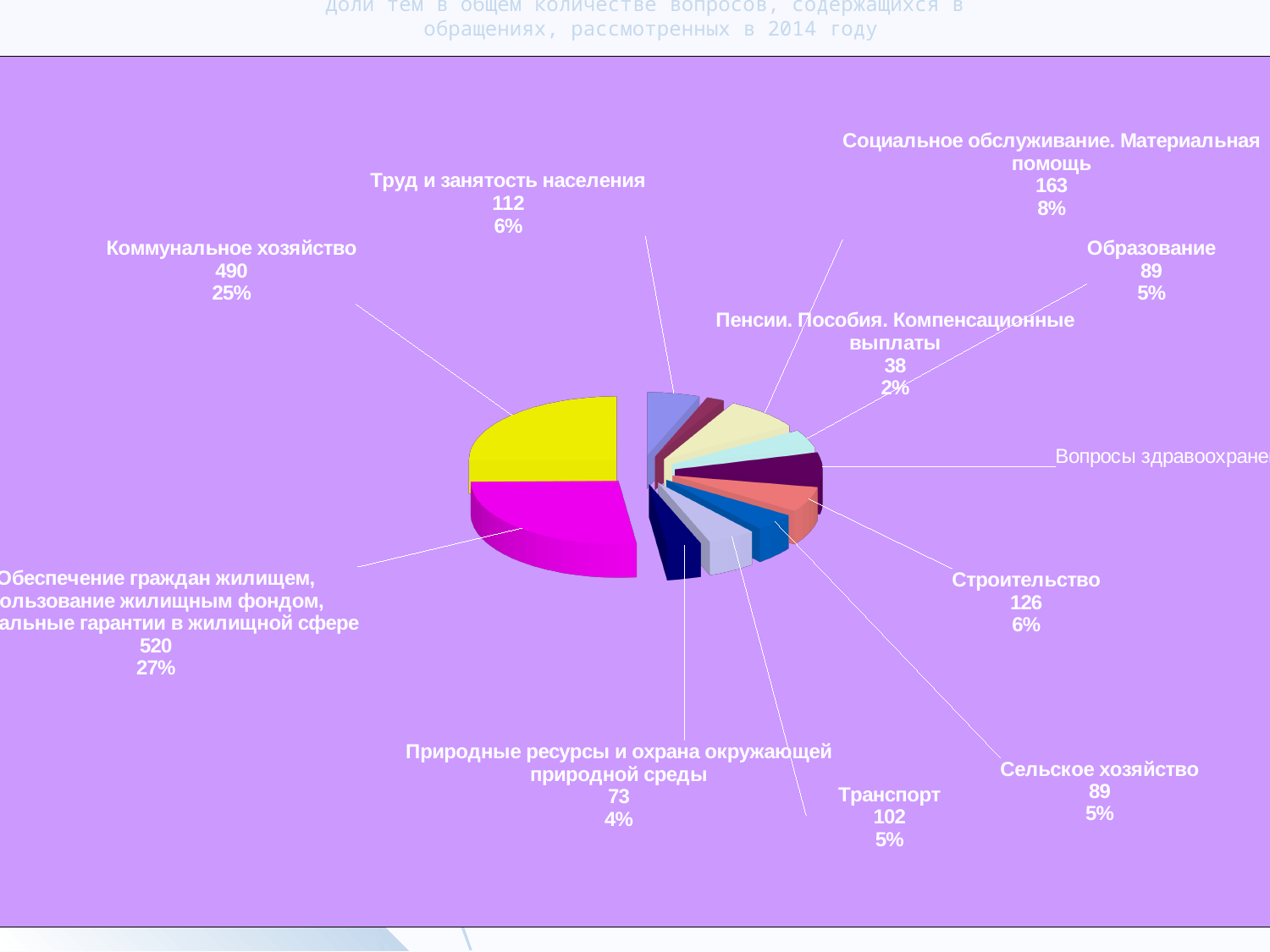
What kind of chart is shown on the slide? Pie chart What percentage is shown for Социальное обслуживание. Материальная помощь? 8% What is the difference between the values for Социальное обслуживание. Материальная помощь and Образование? 74 What is the largest percentage share printed on the chart? 27% What percentage is shown for Природные ресурсы и охрана окружающей природной среды? 4% Which year is mentioned in the chart title? 2014 Which category has the smallest printed value on the chart? Пенсии. Пособия. Компенсационные выплаты What is the difference between the values for Коммунальное хозяйство and Труд и занятость населения? 378 What is the value shown for Сельское хозяйство? 89 What share of the pie does Строительство represent? 6% Which has the larger value, Строительство or Транспорт? Строительство What is the value shown for Коммунальное хозяйство? 490